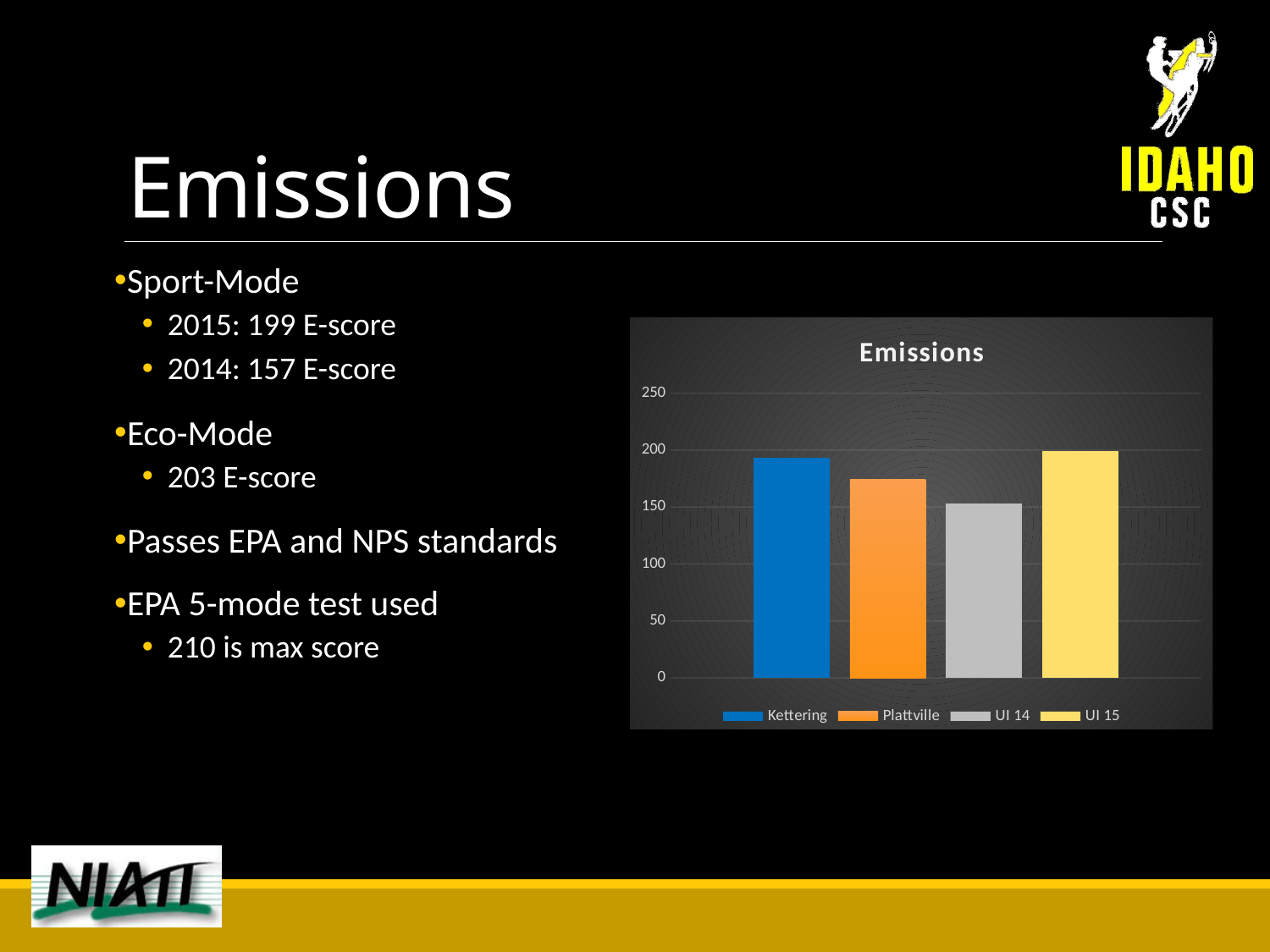
How many series does the chart legend list? 4 How many bars are plotted in the Emissions chart? 4 Which is larger, the value for UI 14 or the value for UI 15? UI 15 What kind of chart is shown on the slide? bar chart What is the title of the chart? Emissions Is the value for Kettering greater or less than 200? less Is the value for Plattville greater or less than 200? less Which is larger, the value for Kettering or the value for Plattville? Kettering Which series has the lowest bar in the Emissions chart? UI 14 Is the value for UI 14 greater or less than 200? less